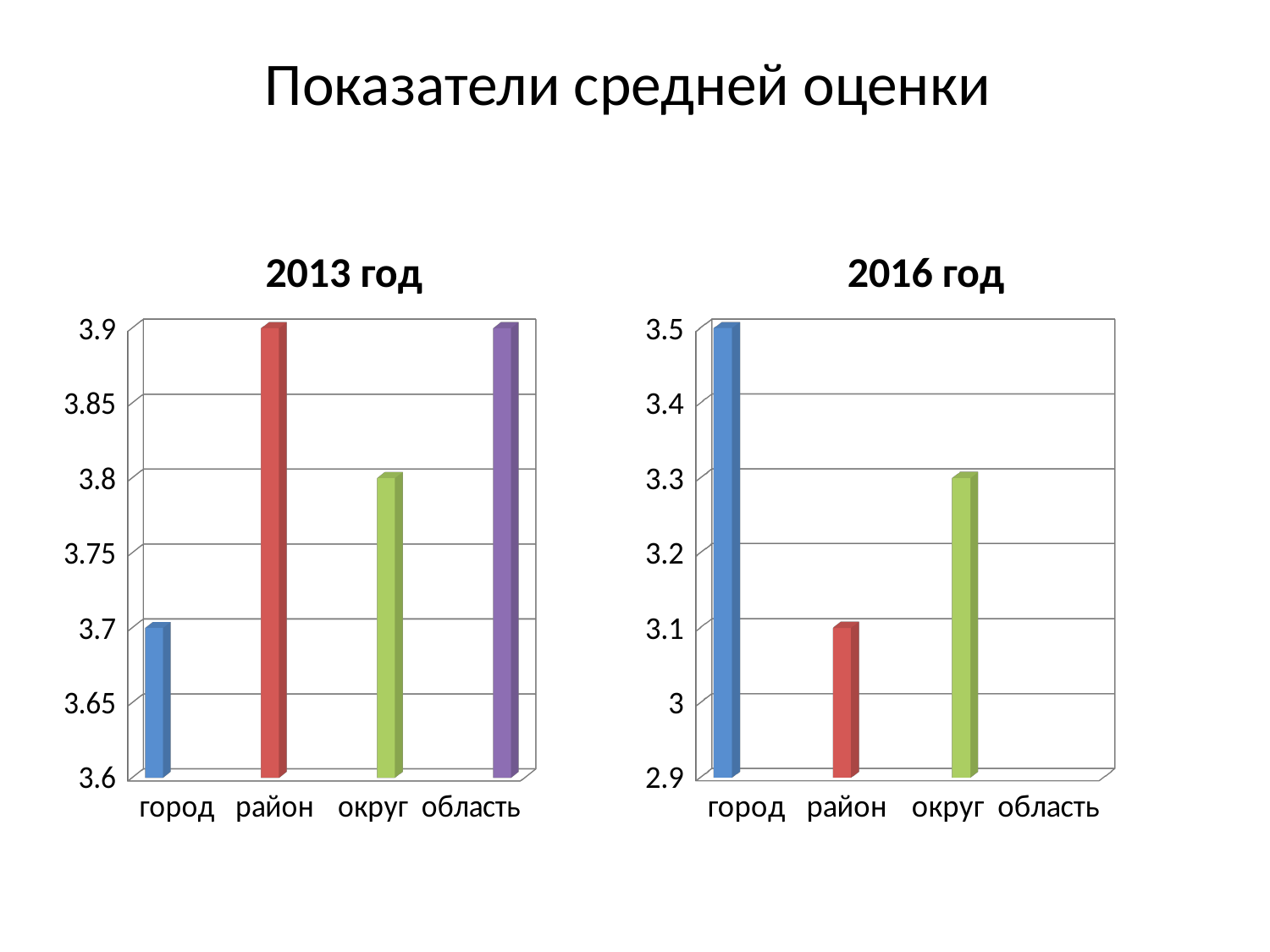
In the "2016 год" chart, which category has the highest value? город In the "2013 год" chart, what is the value for город? 3.7 In the "2013 год" chart, what is the value for округ? 3.8 In the "2013 год" chart, which category has the lowest value? город How many categories are shown on the x axis of the "2013 год" chart? 4 In the "2013 год" chart, what is the value for район? 3.9 What kind of chart is the "2016 год" chart? bar chart In the "2016 год" chart, which is larger, the value for округ or the value for район? округ In the "2016 год" chart, what is the value for район? 3.1 In the "2016 год" chart, what is the value for округ? 3.3 In the "2013 год" chart, what is the difference between the values for район and город? 0.2 In the "2016 год" chart, what is the value for город? 3.5